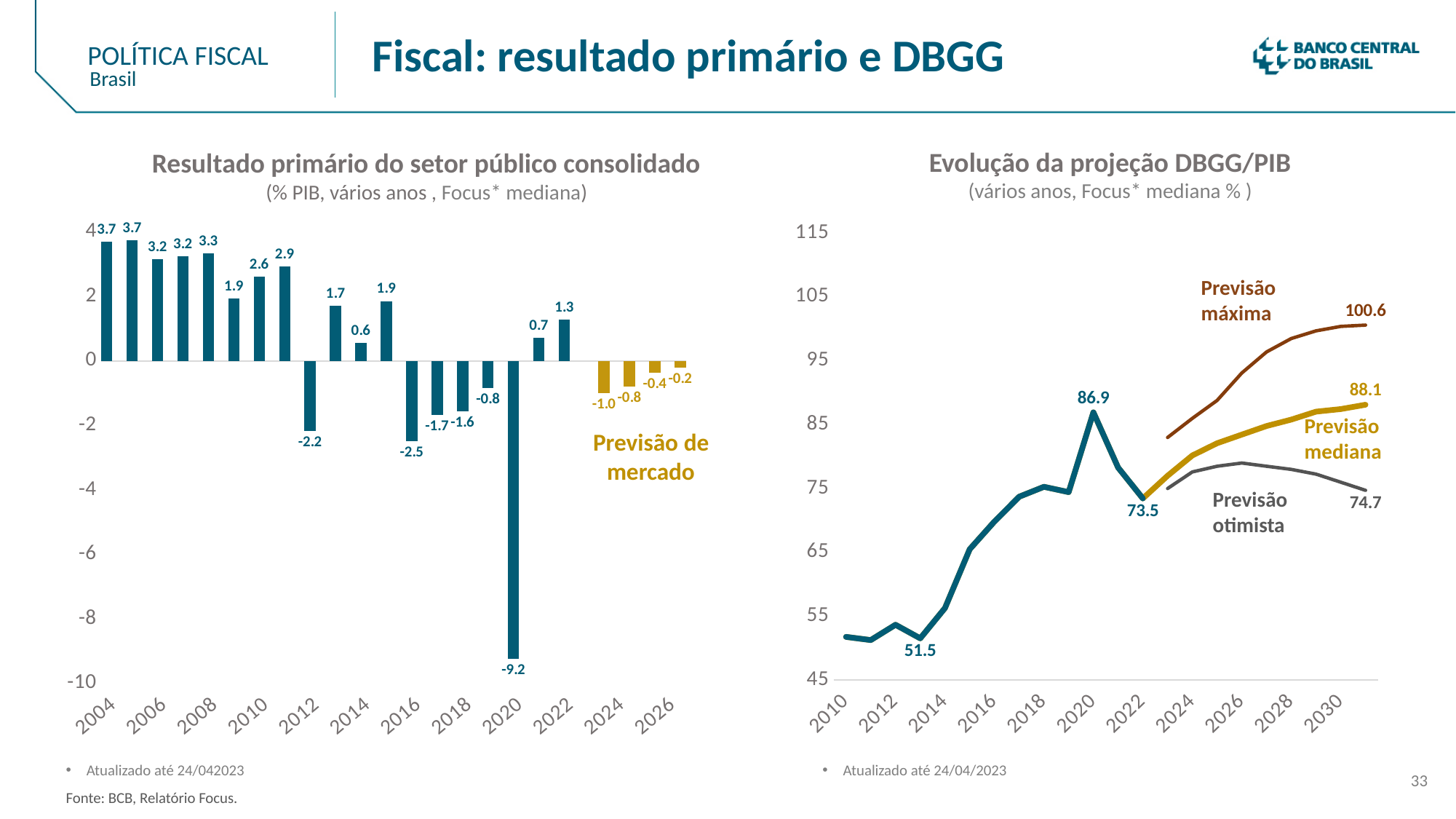
In the left chart, 'Resultado primário do setor público consolidado', what is the value for 2026? -0.2 In the right chart, 'Evolução da projeção DBGG/PIB', what is the peak value labelled at 2020? 86.9 In the right chart, 'Evolução da projeção DBGG/PIB', does the line generally rise or fall from 2010 to 2020? Rise In the left chart, 'Resultado primário do setor público consolidado', what is the value for 2004? 3.7 In the left chart, 'Resultado primário do setor público consolidado', how many bars are shown in the gold 'Previsão de mercado' colour? 4 In the left chart, 'Resultado primário do setor público consolidado', which year has the lowest value? 2020 What kind of chart is the left chart, 'Resultado primário do setor público consolidado'? Bar chart In the left chart, 'Resultado primário do setor público consolidado', what is the difference between the 2022 value and the 2021 value? 0.6 In the right chart, 'Evolução da projeção DBGG/PIB', what is the final value of the 'Previsão máxima' line? 100.6 In the right chart, 'Evolução da projeção DBGG/PIB', is the value for 2018 greater or less than 65? greater In the left chart, 'Resultado primário do setor público consolidado', what is the value for 2020? -9.2 In the right chart, 'Evolução da projeção DBGG/PIB', what is the difference between the final values of 'Previsão máxima' and 'Previsão otimista'? 25.9